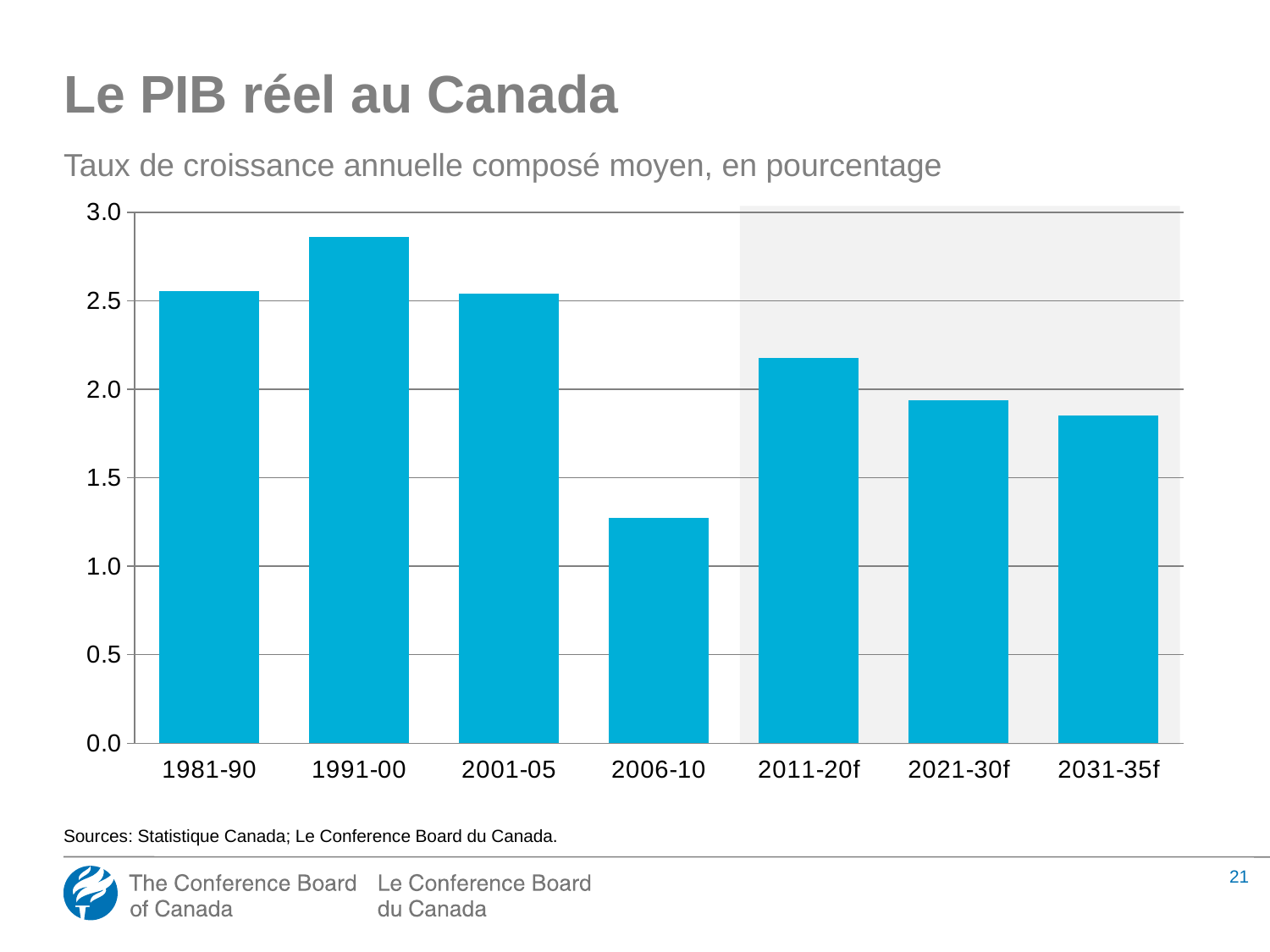
Is the value for 1991-00 greater or less than 2.5? greater Is the value for 2031-35f greater or less than 2.0? less Which is larger, the value for 2011-20f or the value for 2021-30f? 2011-20f Is the value for 2006-10 greater or less than 1.5? less Which period has the highest growth rate in the chart? 1991-00 How many periods are shown on the x axis of the chart? 7 What kind of chart is shown on the slide? Bar chart Do the values rise or fall across the forecast periods from 2011-20f to 2031-35f? Fall Which is larger, the value for 2006-10 or the value for 2031-35f? 2031-35f What is the title of the chart on the slide? Le PIB réel au Canada Which period has the lowest growth rate in the chart? 2006-10